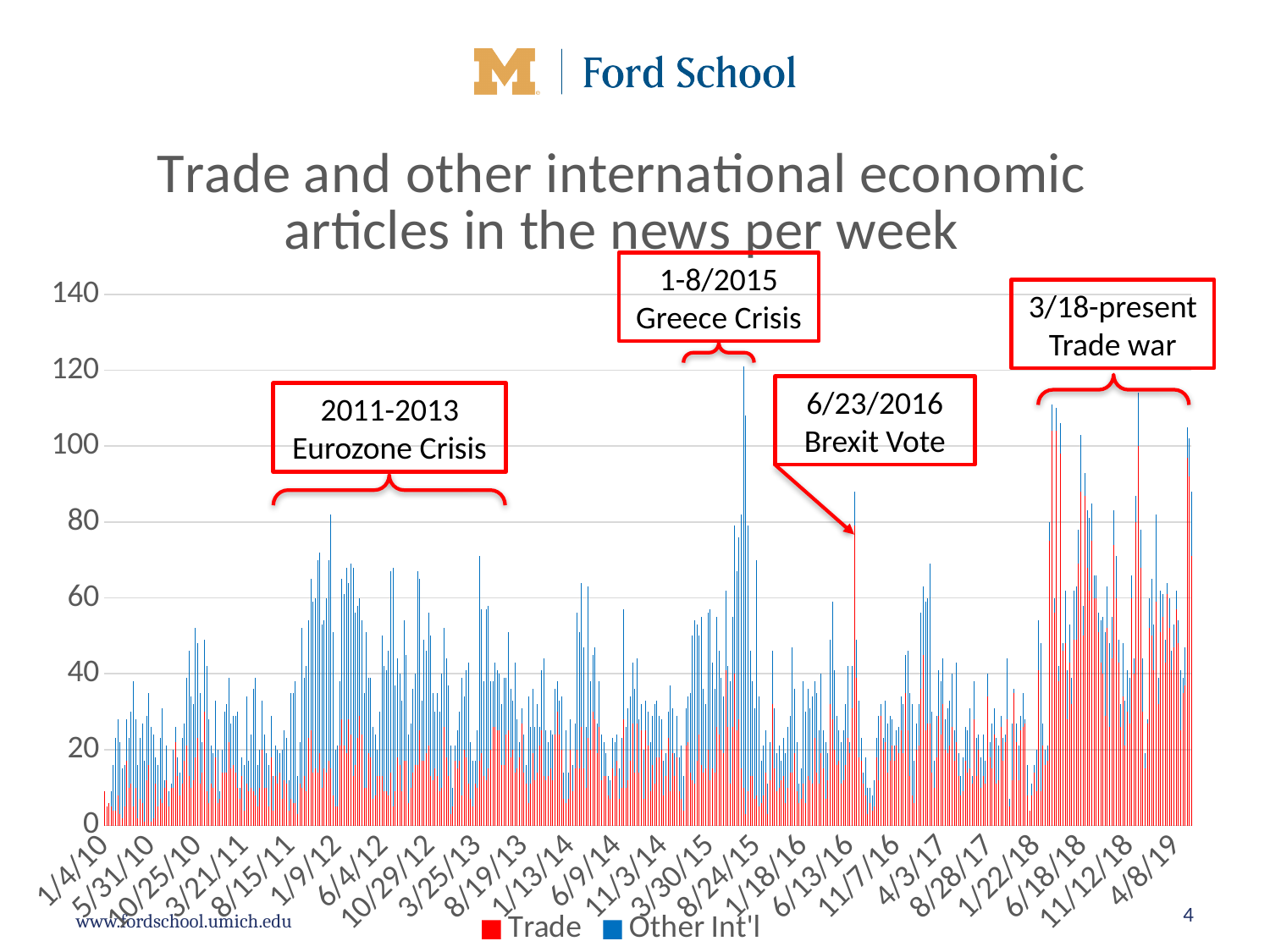
Is the tallest Other Int'l bar on the chart (around 8/24/15) greater or less than 100? greater Is the tallest Other Int'l bar during the 2011-2013 Eurozone Crisis period greater or less than 100? less Is the tallest Trade bar during the 2018 trade war period greater or less than 80? greater What kind of chart is shown on the slide? bar chart What are the two series named in the legend? Trade and Other Int'l How many series does the legend list? 2 Which event is annotated on the chart at 6/23/2016? Brexit Vote